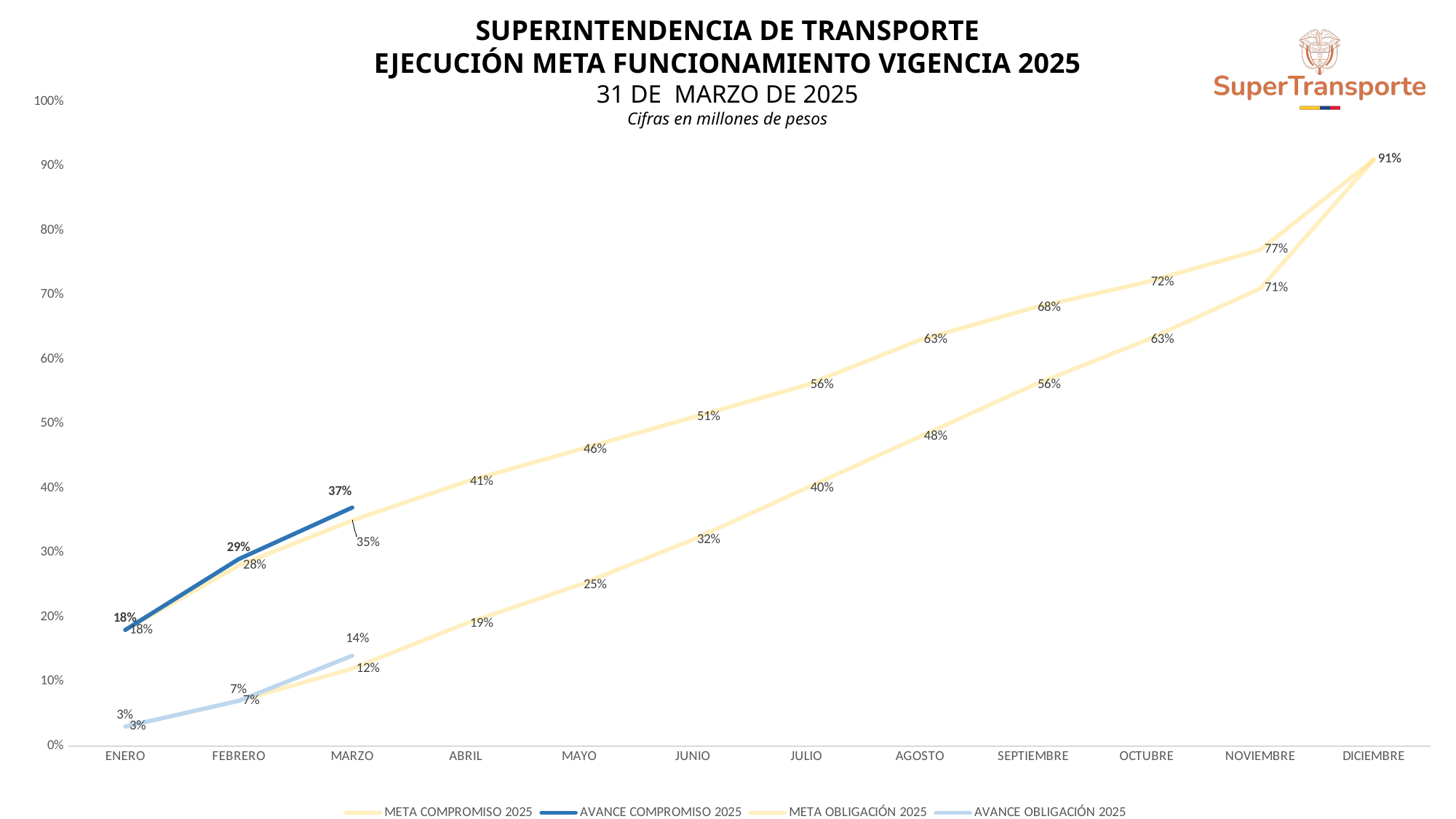
In which month does META COMPROMISO 2025 reach its highest value? DICIEMBRE By how many percentage points does AVANCE COMPROMISO 2025 exceed META COMPROMISO 2025 in MARZO? 2 percentage points What is the value of AVANCE OBLIGACIÓN 2025 in MARZO? 14% How many series does the legend list? 4 In SEPTIEMBRE, which is larger: META COMPROMISO 2025 or META OBLIGACIÓN 2025? META COMPROMISO 2025 What is the value of AVANCE COMPROMISO 2025 in FEBRERO? 29% How many months are shown on the x axis? 12 What type of chart is shown on the slide? Line chart What is the value of META COMPROMISO 2025 in ABRIL? 41% Does META OBLIGACIÓN 2025 rise or fall from ENERO to DICIEMBRE? Rise What is the value of META OBLIGACIÓN 2025 in JULIO? 40% What is the value of AVANCE COMPROMISO 2025 in MARZO? 37%